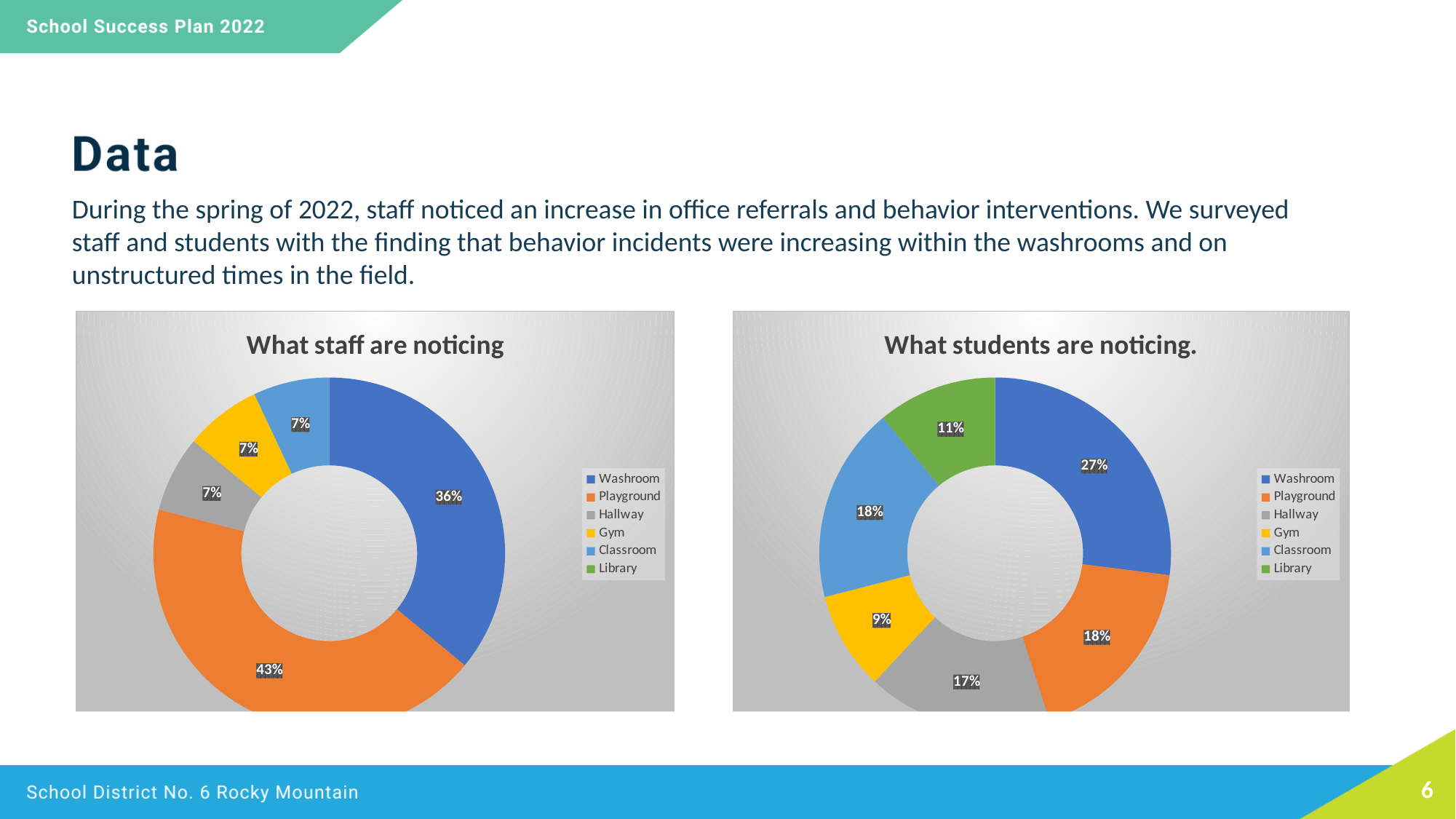
In the 'What students are noticing.' chart, which category has the smallest share? Gym In the 'What students are noticing.' chart, what percentage is shown for Hallway? 17% In the 'What students are noticing.' chart, what percentage is shown for Library? 11% How many entries does the legend of the 'What students are noticing.' chart list? 6 In the 'What staff are noticing' chart, what percentage is shown for Playground? 43% In the 'What staff are noticing' chart, what percentage is shown for Washroom? 36% In the 'What students are noticing.' chart, which category has the largest share? Washroom In the 'What staff are noticing' chart, which category has the largest share? Playground In the 'What staff are noticing' chart, what is the difference between the Playground and Washroom percentages? 7% In the 'What students are noticing.' chart, what is the difference between the Washroom and Gym percentages? 18% In the 'What students are noticing.' chart, which is larger, Washroom or Playground? Washroom What kind of chart is 'What staff are noticing'? doughnut chart